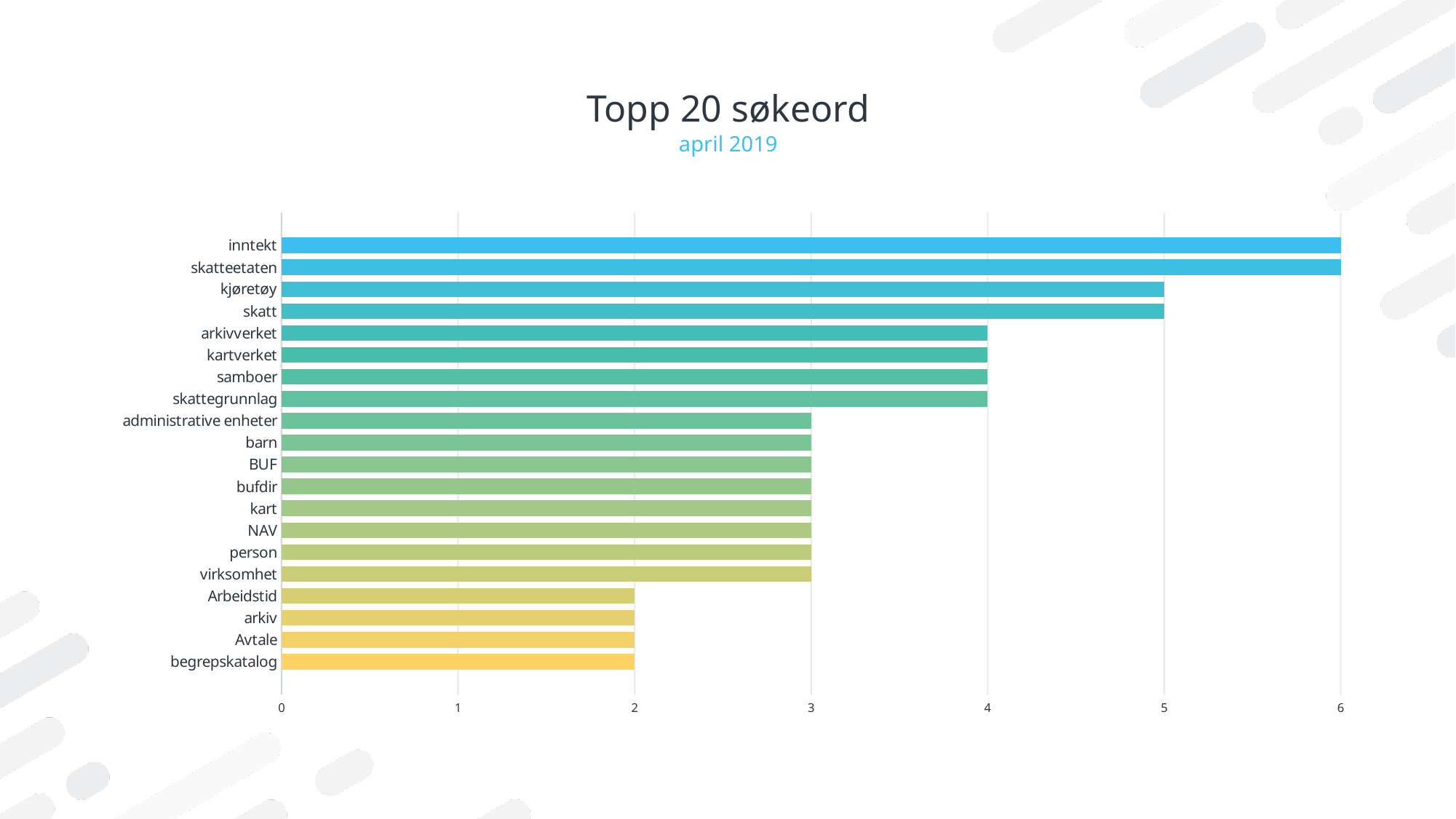
Is the value for kartverket greater or less than 3? greater What is the value for inntekt? 6 What is the difference between the values for skatteetaten and Arbeidstid? 4 What is the value for begrepskatalog? 2 How many search terms (categories) are plotted in the chart? 20 What is the value for samboer? 4 What is the title of the chart? Topp 20 søkeord What kind of chart is shown on the slide? bar chart Which has a larger value, skatt or NAV? skatt What is the highest value shown in the chart? 6 What is the value for kjøretøy? 5 What is the lowest value shown in the chart? 2